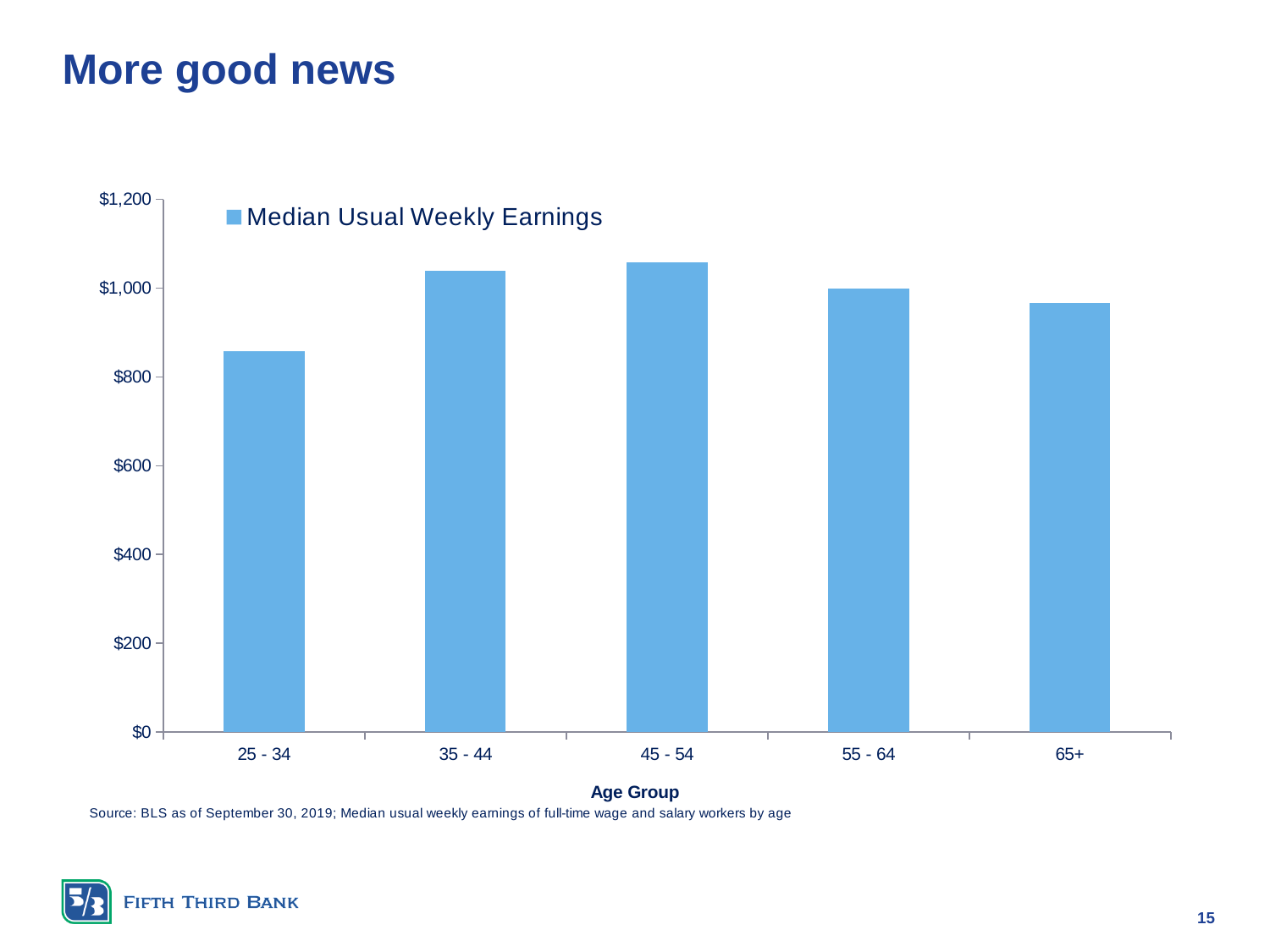
How many age groups are shown on the x axis of the chart? 5 Which age group has the lowest median usual weekly earnings? 25 - 34 Is the value for the 25 - 34 age group greater or less than $800? greater Is the value for the 35 - 44 age group greater or less than $1,000? greater What kind of chart is shown on the slide? Bar chart What is the title of the x axis of the chart? Age Group Do the values rise or fall along the x axis from the 45 - 54 age group to the 65+ age group? fall Is the value for the 65+ age group greater or less than $1,000? less How many series does the chart's legend list? 1 Which has higher median usual weekly earnings, the 35 - 44 age group or the 25 - 34 age group? 35 - 44 Which has higher median usual weekly earnings, the 25 - 34 age group or the 65+ age group? 65+